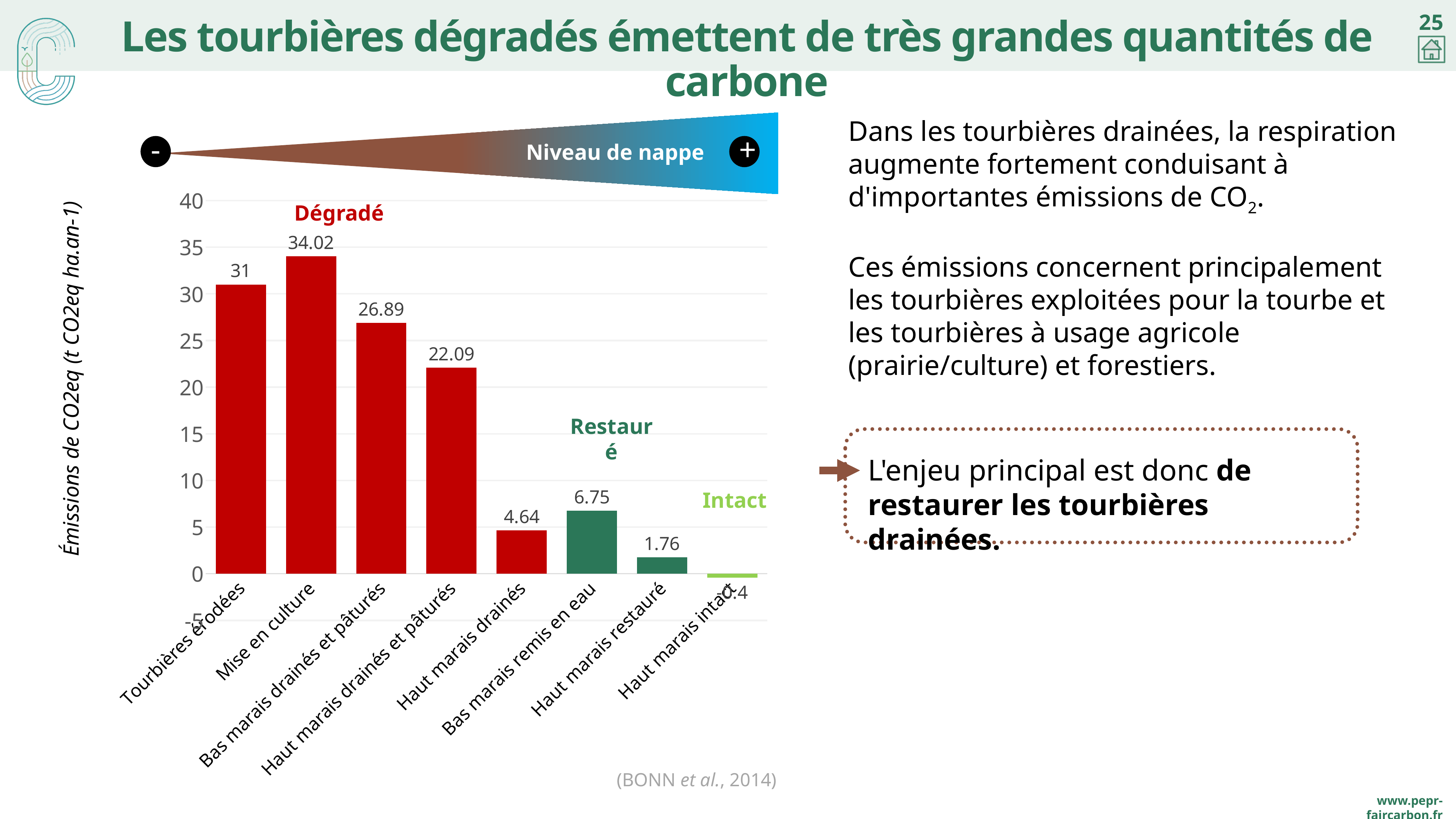
Which category has the highest value? Mise en culture What is the value for Bas marais remis en eau? 6.75 What is the value for Haut marais restauré? 1.76 How many categories are plotted on the x axis of the chart? 8 What type of chart is shown on the slide? bar chart Which is larger, the value for Haut marais drainés or the value for Bas marais remis en eau? Bas marais remis en eau What is the value for Bas marais drainés et pâturés? 26.89 Is the value for Haut marais drainés et pâturés greater or less than 20? greater Which category has the lowest value? Haut marais intact What colour are the bars in the Dégradé group? red What is the difference between the values for Mise en culture and Tourbières érodées? 3.02 What is the value for Mise en culture? 34.02